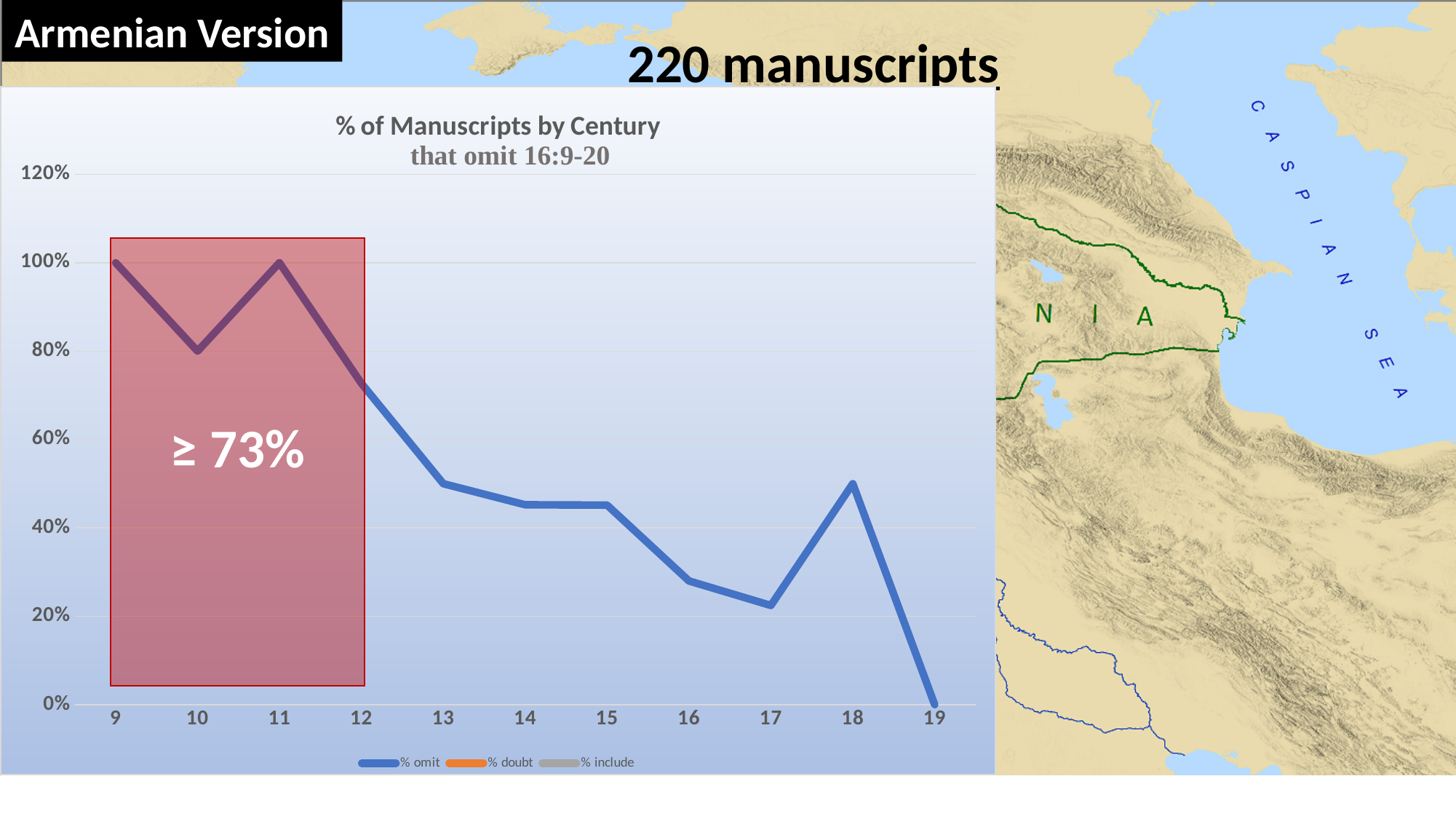
What is the % omit value for century 10? 80% How many series does the chart legend list? 3 What is the title of the chart? % of Manuscripts by Century that omit 16:9-20 What is the % omit value for century 9? 100% Which has a larger % omit value, century 13 or century 16? century 13 Which century has the lowest % omit value? 19 What is the difference between the % omit values for century 9 and century 10? 20% What is the % omit value for century 19? 0% Is the % omit value for century 12 greater or less than 60%? greater What kind of chart is shown on the slide? line chart How many centuries are plotted along the x axis? 11 Is the % omit value for century 17 greater or less than 40%? less